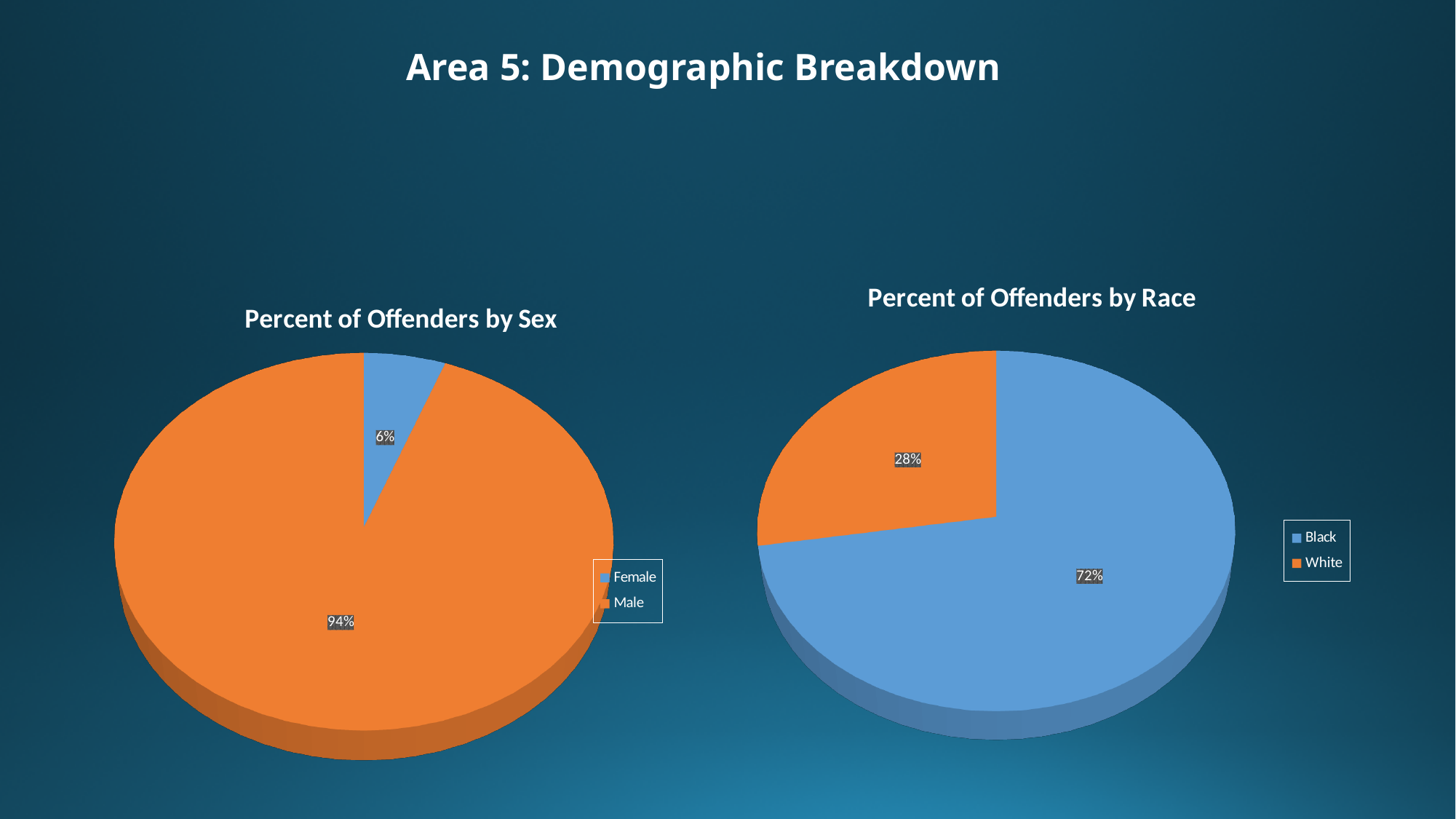
In the 'Percent of Offenders by Sex' chart, what percentage of offenders are Male? 94% In the 'Percent of Offenders by Sex' chart, what colour is the Female slice? Blue In the 'Percent of Offenders by Sex' chart, which category has the largest share? Male In the 'Percent of Offenders by Race' chart, which is larger, the share for Black or the share for White? Black In the 'Percent of Offenders by Race' chart, what is the difference in percentage points between Black and White? 44 What type of chart is 'Percent of Offenders by Sex'? Pie chart In the 'Percent of Offenders by Race' chart, what percentage of offenders are Black? 72% In the 'Percent of Offenders by Sex' chart, what percentage of offenders are Female? 6% How many categories does the legend of the 'Percent of Offenders by Race' chart list? 2 In the 'Percent of Offenders by Sex' chart, what is the difference in percentage points between Male and Female? 88 In the 'Percent of Offenders by Race' chart, what percentage of offenders are White? 28% In the 'Percent of Offenders by Race' chart, which category has the smallest share? White